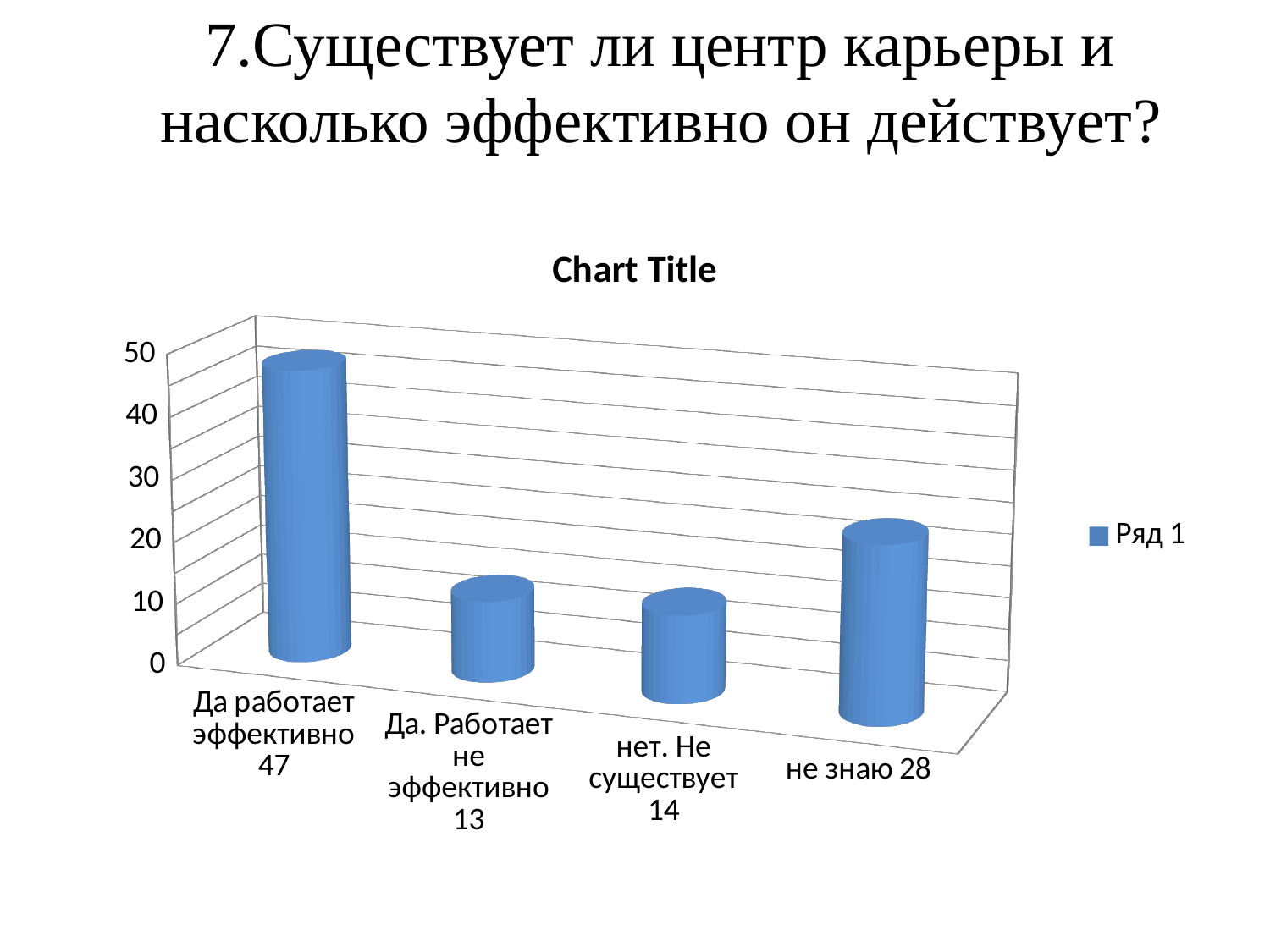
How many series does the legend list? 1 What is the difference between the values for "Да работает эффективно" and "не знаю"? 19 How many categories are shown on the chart? 4 Which category has the lowest value? Да. Работает не эффективно What is the difference between the values for "не знаю" and "нет. Не существует"? 14 What value is shown for the category "Да. Работает не эффективно"? 13 What value is shown for the category "нет. Не существует"? 14 Which is larger, the value for "не знаю" or the value for "нет. Не существует"? не знаю What value is shown for the category "Да работает эффективно"? 47 What value is shown for the category "не знаю"? 28 What kind of chart is shown on the slide? Bar chart Which category has the highest value? Да работает эффективно